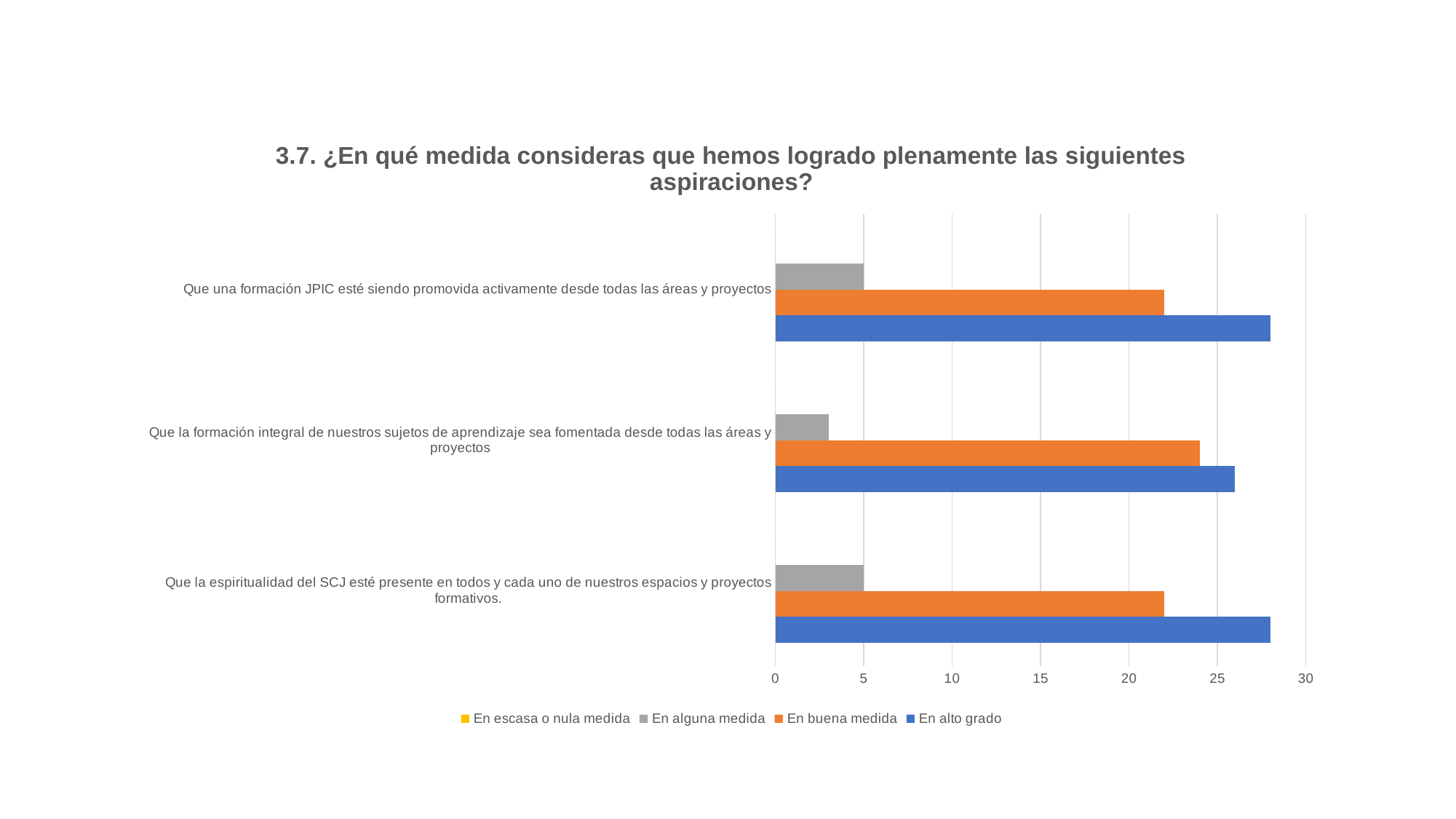
Which series has the highest value for 'Que la formación integral de nuestros sujetos de aprendizaje sea fomentada desde todas las áreas y proyectos'? En alto grado Which legend entry is shown in orange? En buena medida What is the value of 'En alguna medida' for 'Que una formación JPIC esté siendo promovida activamente desde todas las áreas y proyectos'? 5 Is the value of 'En alguna medida' for 'Que la formación integral de nuestros sujetos de aprendizaje sea fomentada desde todas las áreas y proyectos' greater or less than 5? less Is the value of 'En alto grado' for 'Que una formación JPIC esté siendo promovida activamente desde todas las áreas y proyectos' greater or less than 25? greater Is the value of 'En buena medida' for 'Que la formación integral de nuestros sujetos de aprendizaje sea fomentada desde todas las áreas y proyectos' greater or less than 25? less Which category has the lowest 'En alguna medida' value? Que la formación integral de nuestros sujetos de aprendizaje sea fomentada desde todas las áreas y proyectos What is the value of 'En alguna medida' for 'Que la espiritualidad del SCJ esté presente en todos y cada uno de nuestros espacios y proyectos formativos.'? 5 What kind of chart is shown on the slide? bar chart How many categories (aspirations) are plotted on the chart? 3 For 'Que la espiritualidad del SCJ esté presente en todos y cada uno de nuestros espacios y proyectos formativos.', which is larger: 'En buena medida' or 'En alto grado'? En alto grado How many series does the legend list? 4